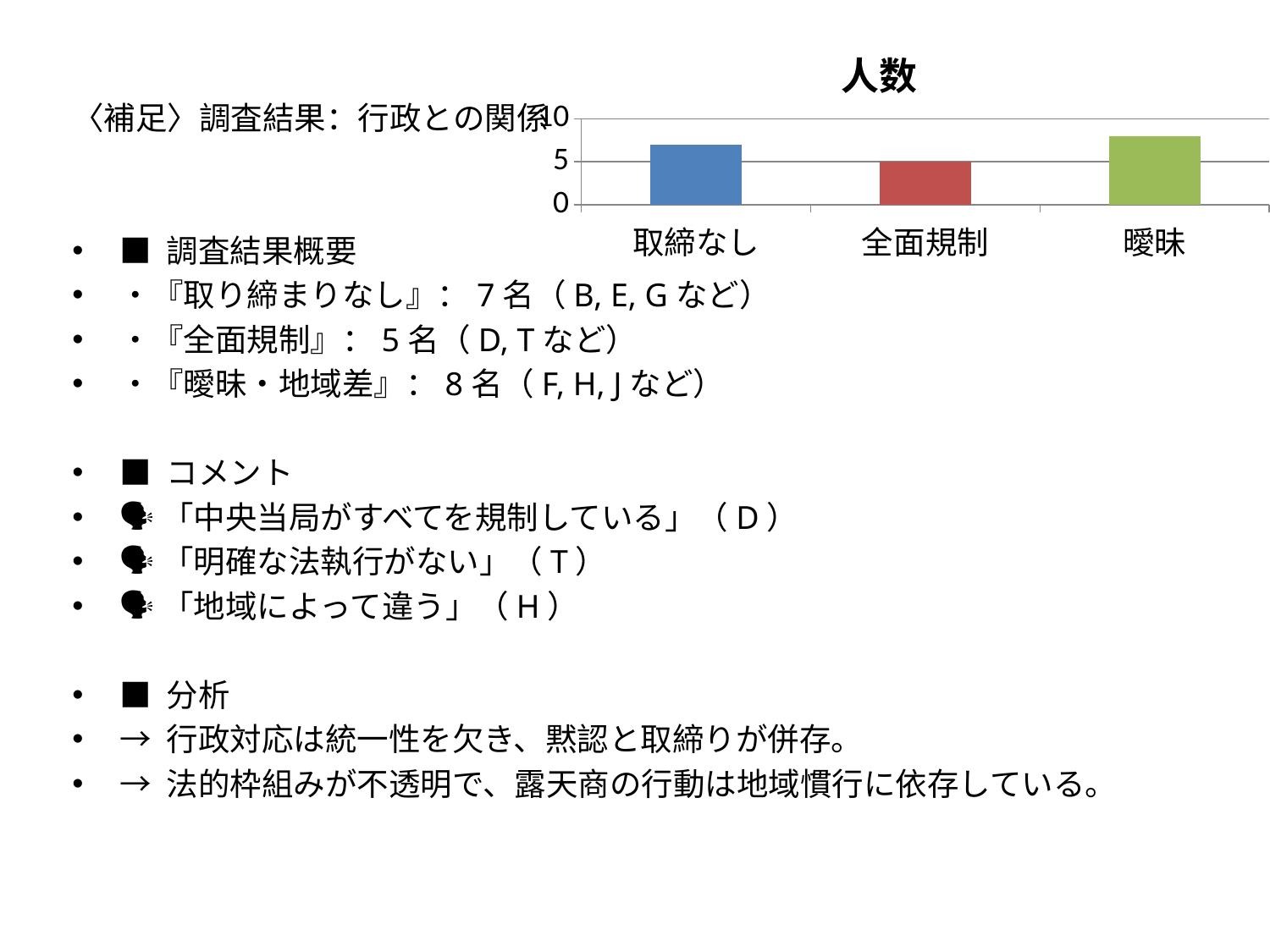
What is the value for 全面規制? 5 Which is larger, the value for 曖昧 or the value for 全面規制? 曖昧 Which category has the lowest value? 全面規制 Is the value for 曖昧 greater or less than 10? less Is the value for 曖昧 greater or less than 5? greater Which category has the highest value? 曖昧 What kind of chart is shown? bar chart Which is larger, the value for 取締なし or the value for 全面規制? 取締なし Is the value for 取締なし greater or less than 5? greater What colour is the bar for 全面規制? red What is the title of the chart? 人数 How many categories are shown on the x axis? 3